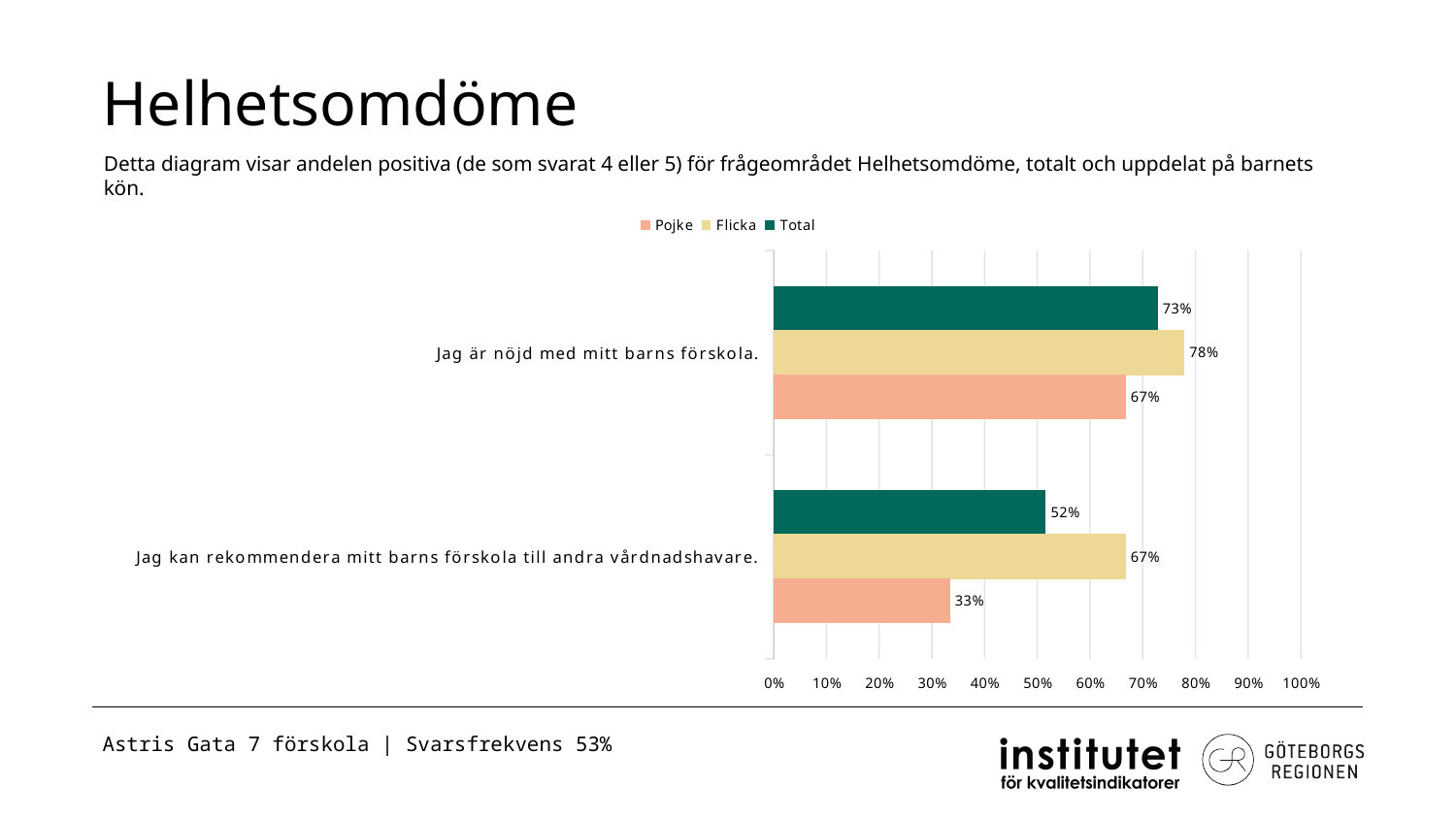
What is the Total value for "Jag är nöjd med mitt barns förskola."? 73% Which series has the lowest value for "Jag är nöjd med mitt barns förskola."? Pojke What is the difference between the Flicka and Pojke values for "Jag är nöjd med mitt barns förskola."? 11 percentage points What is the Pojke value for "Jag kan rekommendera mitt barns förskola till andra vårdnadshavare."? 33% What is the difference between the Flicka and Pojke values for "Jag kan rekommendera mitt barns förskola till andra vårdnadshavare."? 34 percentage points What kind of chart is shown on the slide? Bar chart How many categories (statements) are shown on the chart? 2 What is the Total value for "Jag kan rekommendera mitt barns förskola till andra vårdnadshavare."? 52% Which is larger: the Pojke value for "Jag är nöjd med mitt barns förskola." or the Pojke value for "Jag kan rekommendera mitt barns förskola till andra vårdnadshavare."? Jag är nöjd med mitt barns förskola. Which series has the highest value for "Jag kan rekommendera mitt barns förskola till andra vårdnadshavare."? Flicka What is the Flicka value for "Jag är nöjd med mitt barns förskola."? 78% How many series does the legend list? 3